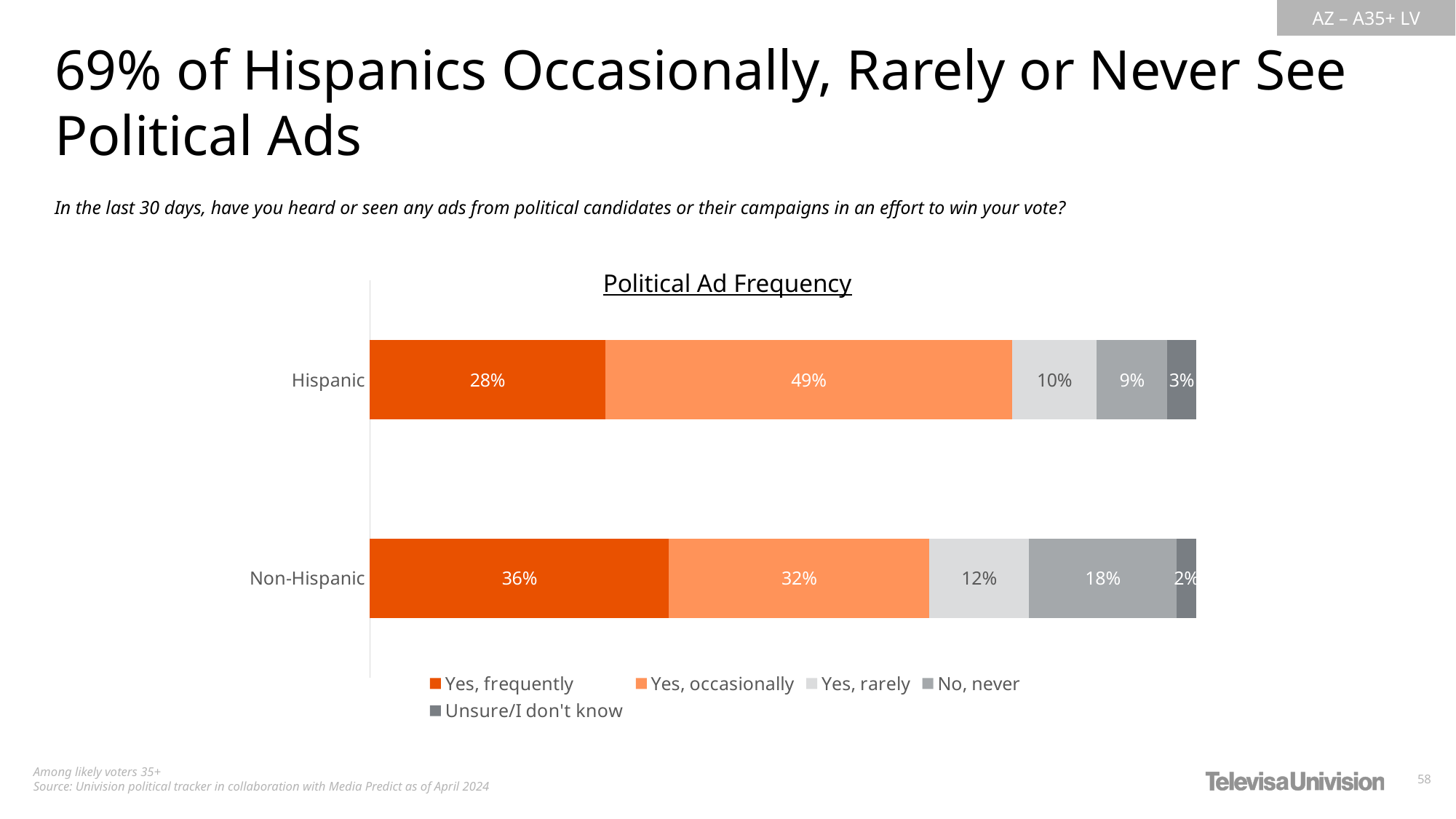
What is the 'No, never' value for Non-Hispanic respondents? 18% Which response category has the smallest share among Non-Hispanic respondents? Unsure/I don't know Which group has a higher 'Yes, frequently' share, Hispanic or Non-Hispanic? Non-Hispanic What type of chart is shown on the slide? Stacked bar chart What is the 'Yes, rarely' value for Hispanic respondents? 10% What percentage of Non-Hispanic respondents said they see political ads occasionally? 32% How many groups (bars) are shown in the chart? 2 What is the difference between the 'Yes, occasionally' values for Hispanic and Non-Hispanic respondents? 17 percentage points Which response category has the largest share among Hispanic respondents? Yes, occasionally What is the title of the chart? Political Ad Frequency What percentage of Hispanic respondents said they see political ads frequently? 28% How many series does the legend list? 5